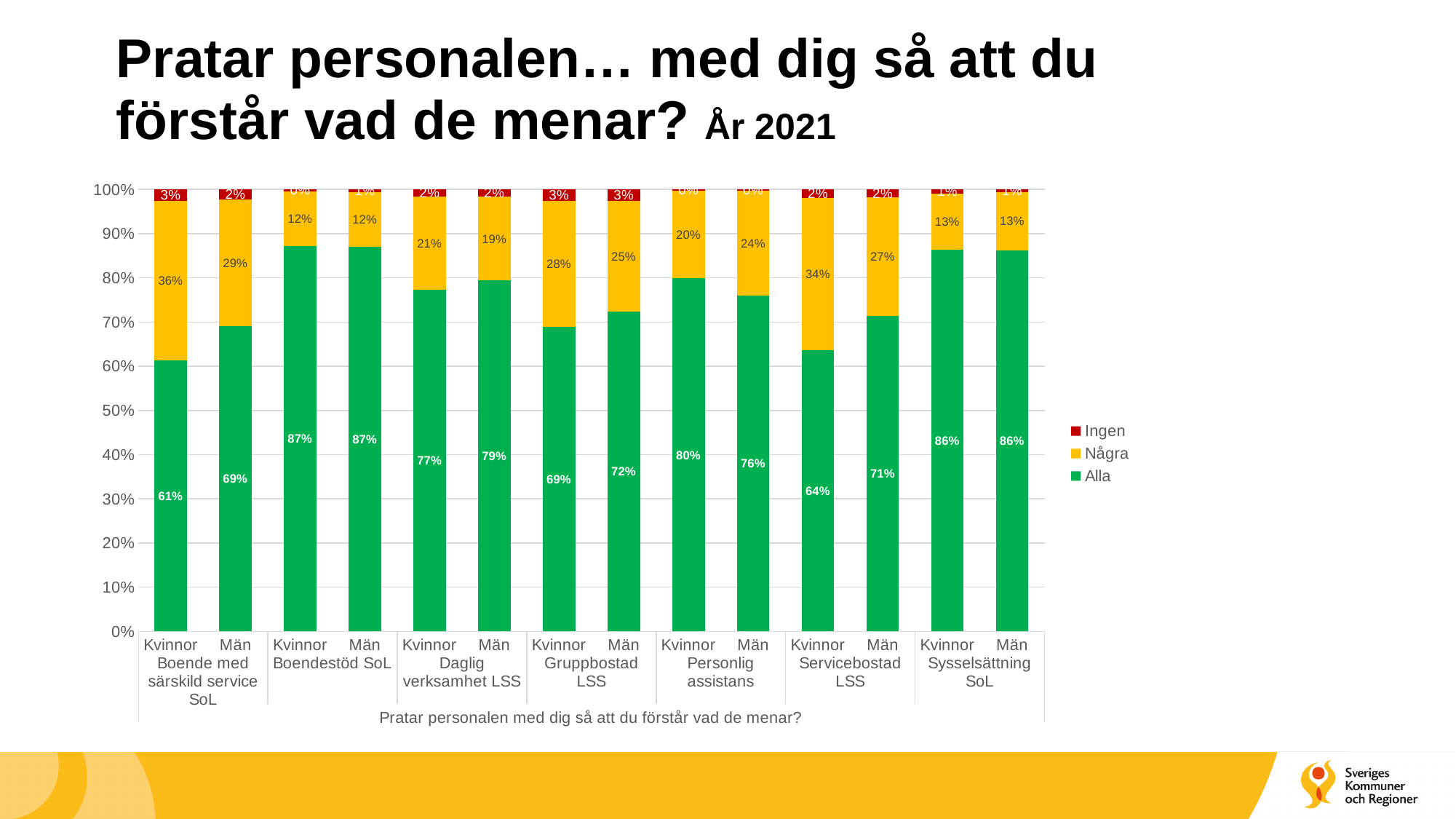
What is the difference between the "Alla" values for men and women in Servicebostad LSS? 7 percentage points How many bars are shown in the chart? 14 Which bar has the lowest "Alla" value? Kvinnor, Boende med särskild service SoL (61%) In Personlig assistans, is the "Alla" value higher for Kvinnor or for Män? Kvinnor What is the "Några" value for men (Män) in Servicebostad LSS? 27% What type of chart is shown on the slide? Stacked bar chart What is the "Ingen" value for women (Kvinnor) in Gruppbostad LSS? 3% Which service area has the highest "Några" value, and what is it? Kvinnor, Boende med särskild service SoL, 36% Is the "Alla" value for men in Daglig verksamhet LSS greater or less than 70%? greater What percentage of women (Kvinnor) in Boende med särskild service SoL answered "Alla"? 61% How many series does the legend list? 3 Which series is shown in green in the chart? Alla